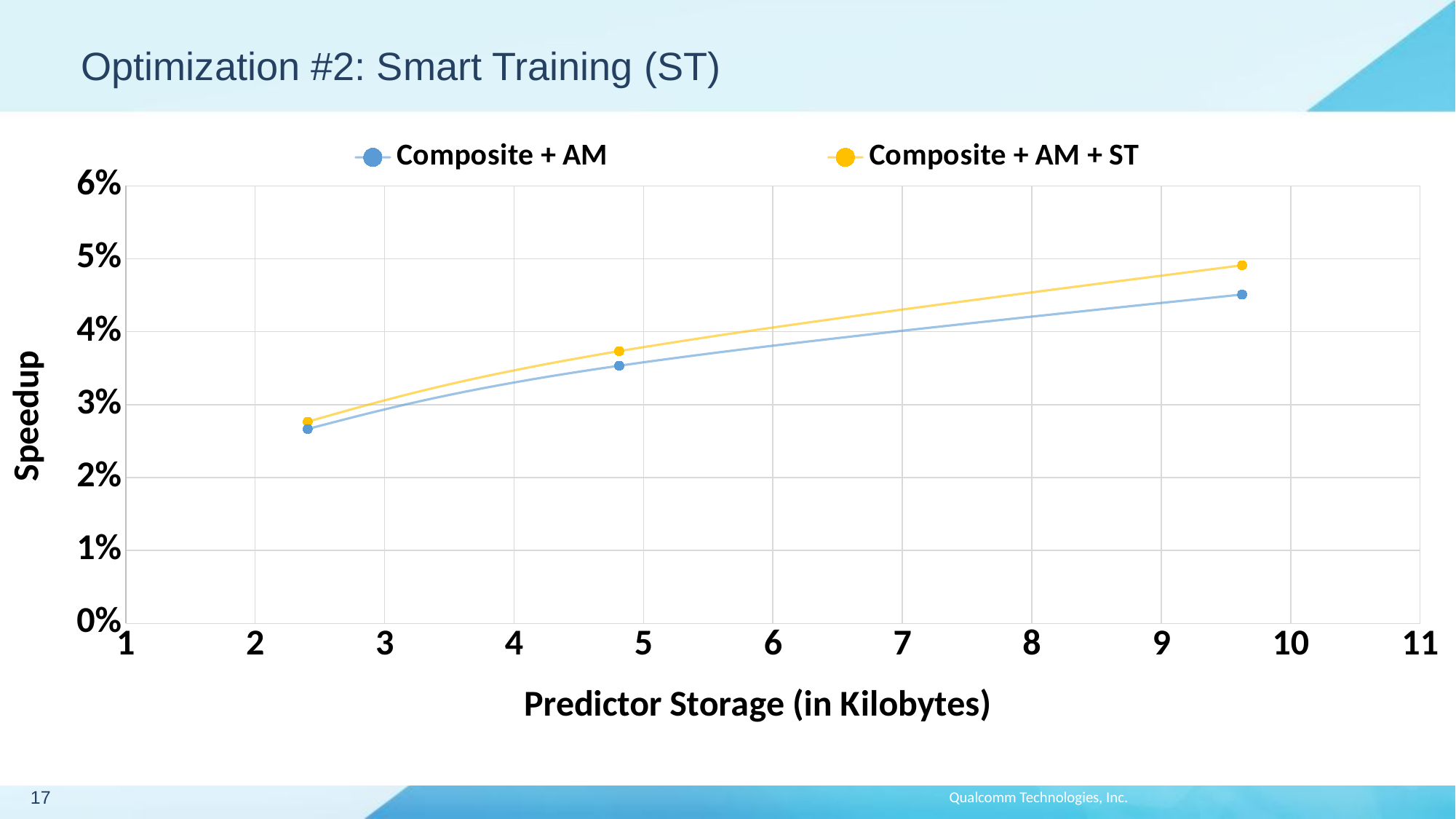
What kind of chart is shown on the slide? line chart At the largest predictor storage plotted, which series has the higher speedup, Composite + AM or Composite + AM + ST? Composite + AM + ST Is the speedup for Composite + AM at its middle predictor storage point greater or less than 3%? greater How many series does the legend list? 2 Is the speedup for Composite + AM + ST at its largest predictor storage point greater or less than 4%? greater How many data points are plotted for the Composite + AM series? 3 What is the label of the x axis? Predictor Storage (in Kilobytes) Is the speedup for Composite + AM at its smallest predictor storage point greater or less than 3%? less Does the speedup for Composite + AM + ST rise or fall as predictor storage increases? rise Which colour is used for the Composite + AM + ST series? yellow Does the speedup for Composite + AM rise or fall as predictor storage increases? rise